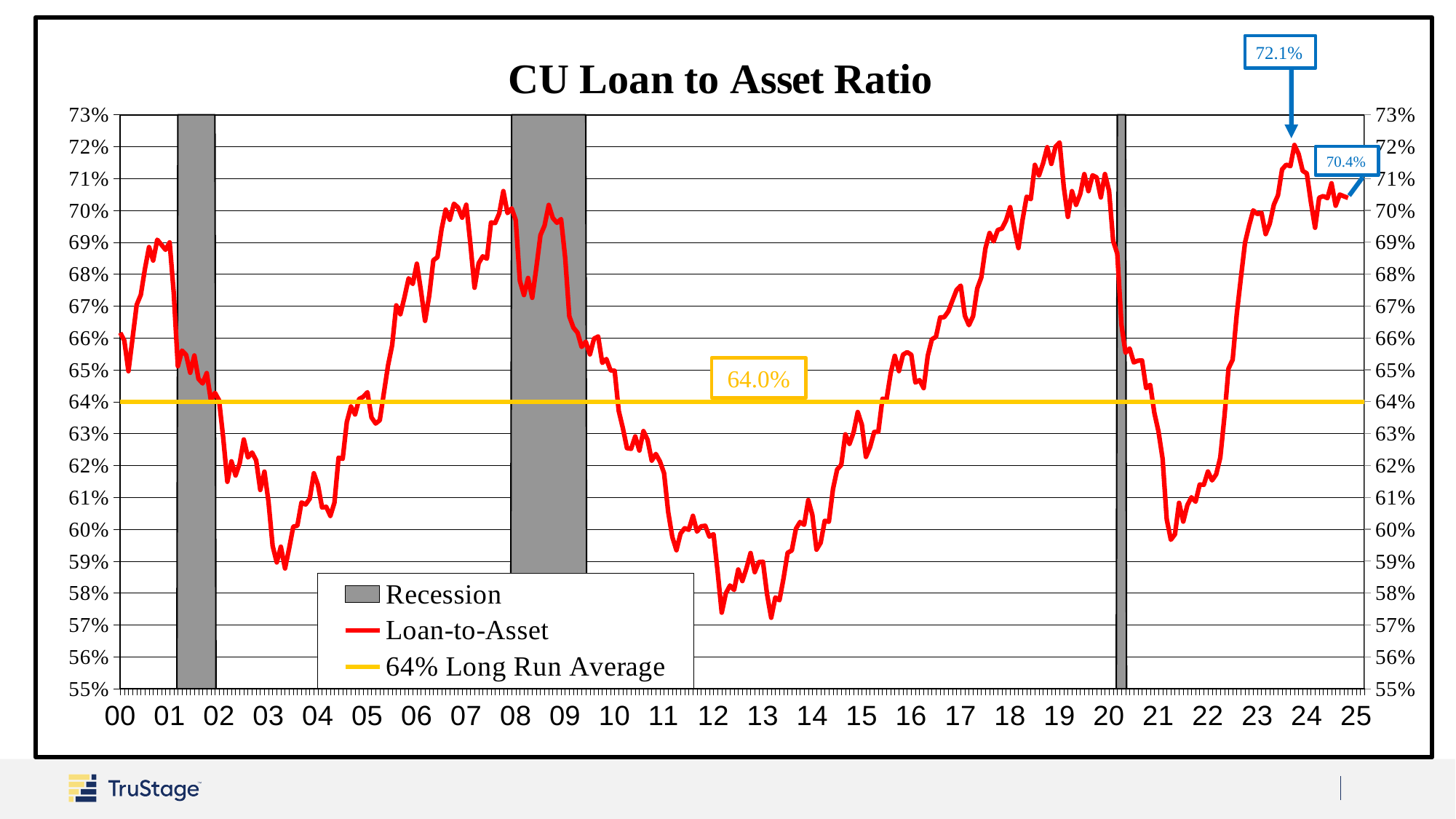
How many shaded recession bands are shown on the chart? 3 What is the title of the chart? CU Loan to Asset Ratio Which is larger, the labelled value of 72.1% or the labelled value of 70.4%? 72.1% Does the Loan-to-Asset line rise or fall between 2021 and 2024? rise What is the labelled peak value of the Loan-to-Asset line near 2024? 72.1% What is the difference between the labelled peak of 72.1% and the latest labelled value of 70.4%? 1.7 percentage points What value is labelled for the long run average line? 64.0% What kind of chart is shown on the slide? line chart Is the Loan-to-Asset value at the start of 2000 greater or less than 65%? greater What is the labelled most recent value of the Loan-to-Asset line at the right end of the chart? 70.4% How many entries does the chart's legend list? 3 By how much does the labelled peak of 72.1% exceed the 64.0% long run average? 8.1 percentage points